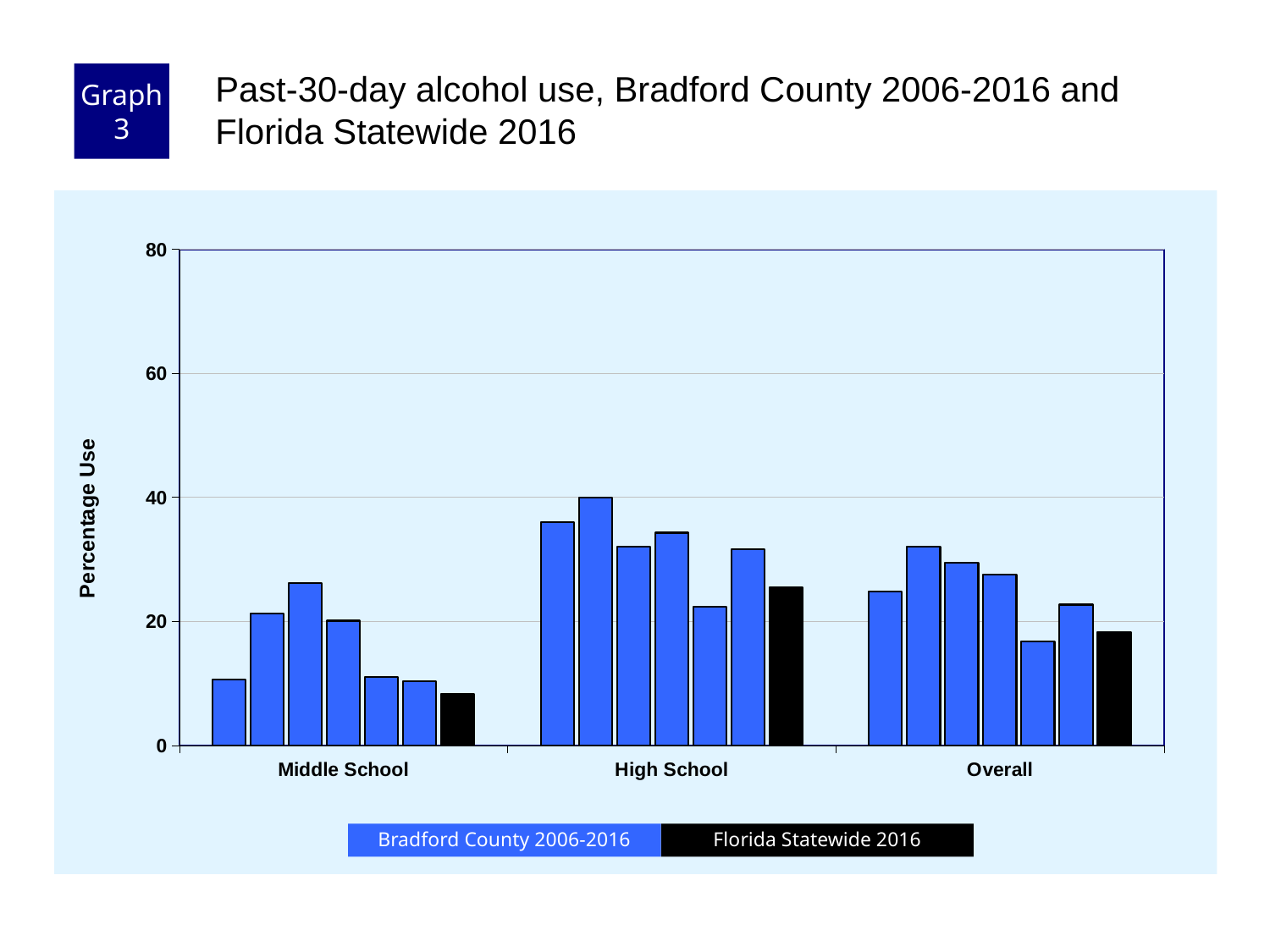
What kind of chart is shown on the slide? bar chart Which category has the highest bar in the chart? High School Is the tallest Bradford County bar for Overall greater or less than 40? less Which is larger, the Florida Statewide 2016 value for High School or for Middle School? High School How many categories are shown on the x axis? 3 How many series does the legend list? 2 Is the Florida Statewide 2016 value for High School greater or less than 20? greater Is the tallest Bradford County bar for Middle School greater or less than 20? greater Which colour represents Florida Statewide 2016 in the legend? black What is the label of the y axis? Percentage Use